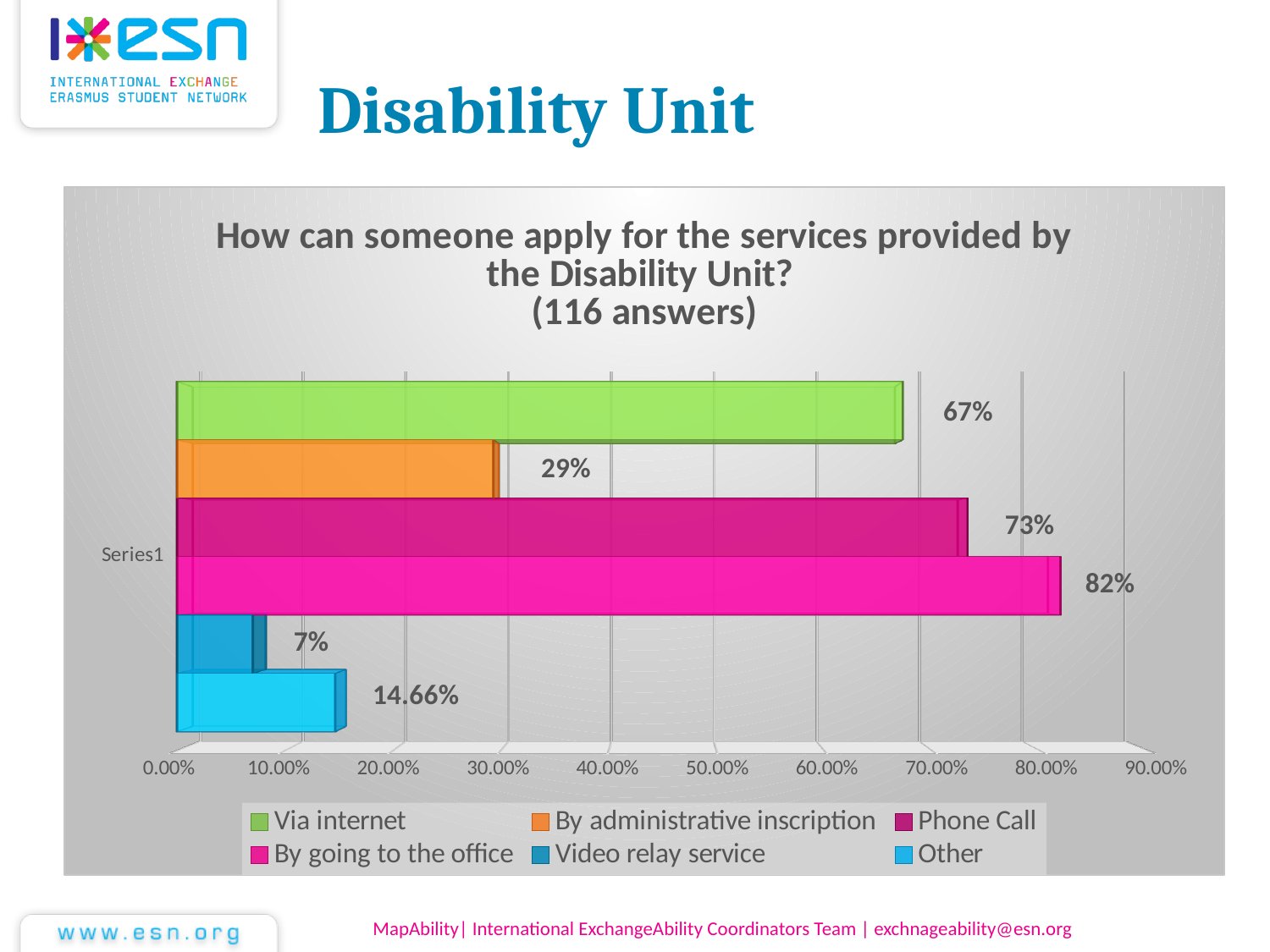
How many series does the legend list? 6 How many answers does the chart title say the survey received? 116 What kind of chart is shown on the slide? Bar chart What is the value shown for 'Other'? 14.66% Is the value for 'By administrative inscription' greater or less than 30.00%? less Which application method has the lowest percentage? Video relay service What is the difference between the values for 'By going to the office' and 'Phone Call'? 9% What percentage of respondents said they can apply via internet? 67% Which is larger, the value for 'Via internet' or the value for 'Phone Call'? Phone Call What is the value shown for 'Video relay service'? 7% Which application method has the highest percentage? By going to the office What is the value shown for 'By going to the office'? 82%